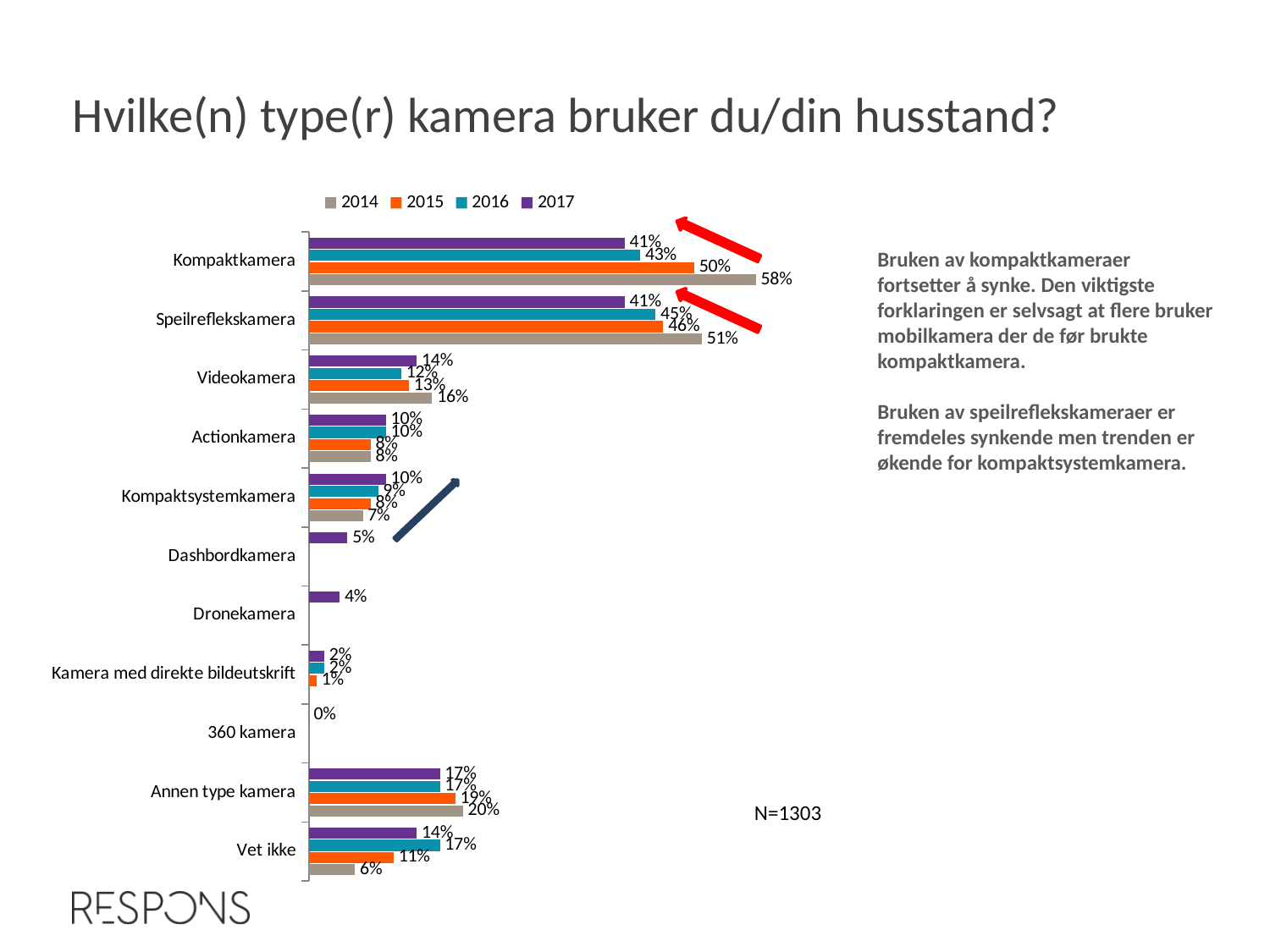
What is the value for Vet ikke in 2014? 6% How many series does the legend list? 4 What is the difference between the 2014 and 2017 values for Kompaktkamera? 17% What is the value for Dronekamera in 2017? 4% Which category has the highest value for 2014? Kompaktkamera Do the values for Kompaktsystemkamera rise or fall from 2014 to 2017? Rise What kind of chart is shown on the slide? Bar chart How many categories are shown on the chart? 11 What sample size (N) is shown on the slide? N=1303 What is the value for Kompaktkamera in 2014? 58% What is the value for Speilreflekskamera in 2017? 41% Which is larger for Annen type kamera: the 2014 value or the 2015 value? 2014